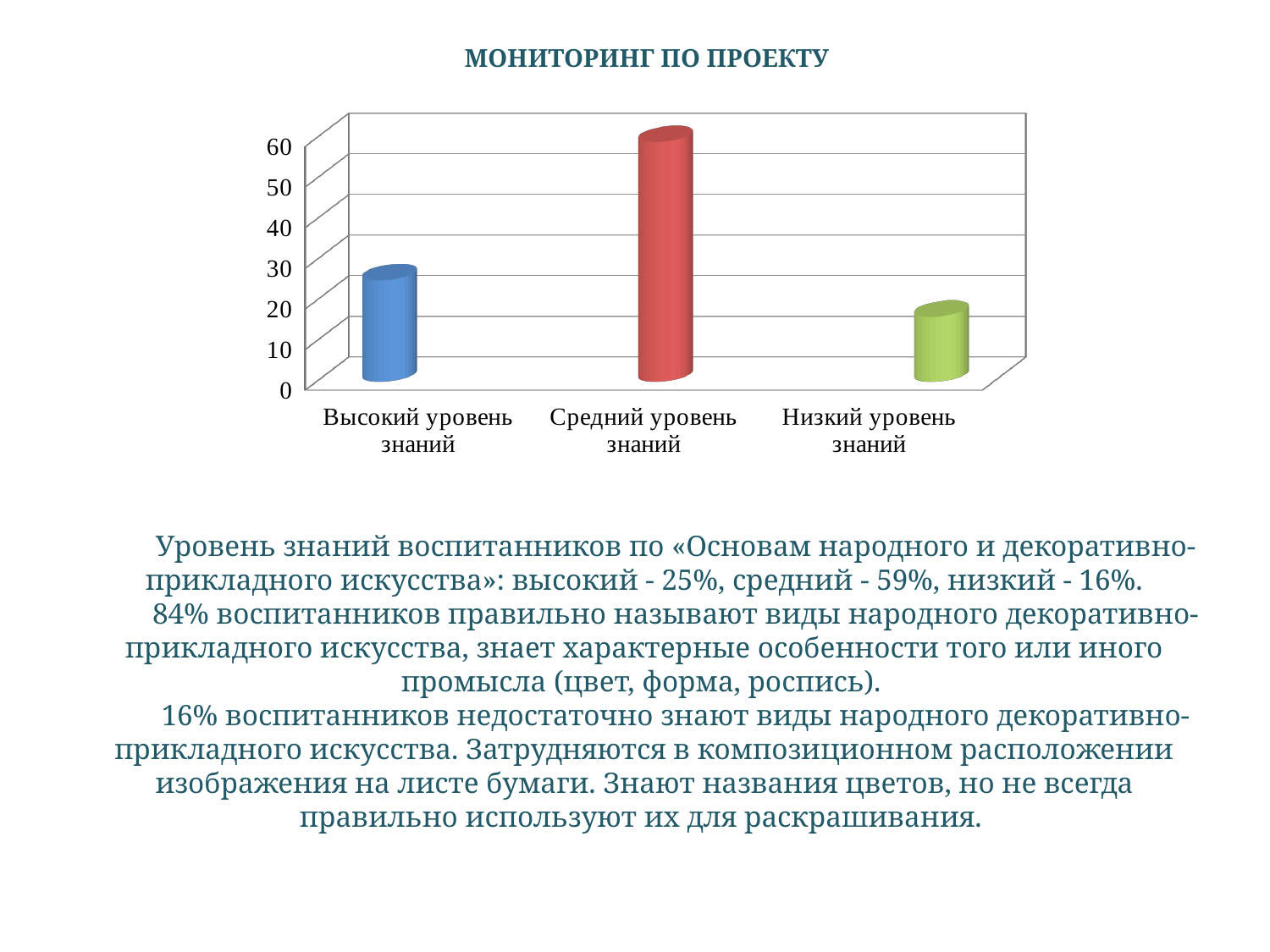
What type of chart is shown on the slide? bar chart Which category has the highest bar? Средний уровень знаний How many categories are shown on the x axis of the chart? 3 What is the title of the chart? МОНИТОРИНГ ПО ПРОЕКТУ Is the value for Средний уровень знаний greater or less than 50? greater Is the value for Высокий уровень знаний greater or less than 30? less According to the slide, what percentage of pupils have a medium level of knowledge (Средний уровень знаний)? 59% According to the slide, what percentage of pupils have a high level of knowledge (Высокий уровень знаний)? 25% Is the value for Низкий уровень знаний greater or less than 20? less Which category has the lowest bar? Низкий уровень знаний What colour is the bar for Средний уровень знаний? red Which is larger, the value for Высокий уровень знаний or the value for Низкий уровень знаний? Высокий уровень знаний